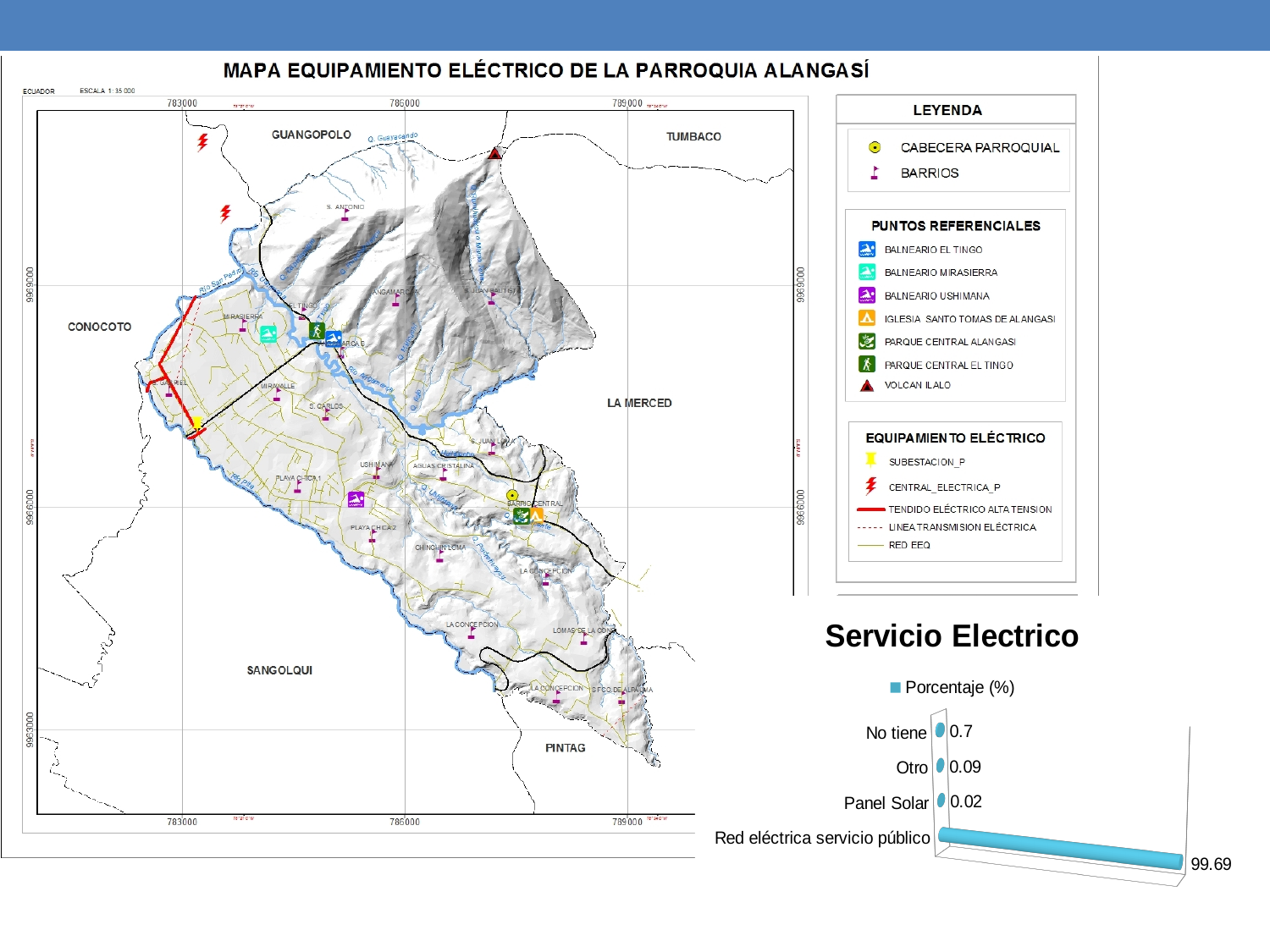
How many categories are shown in the 'Servicio Electrico' chart? 4 In the 'Servicio Electrico' chart, what is the value for 'Red eléctrica servicio público'? 99.69 In the 'Servicio Electrico' chart, which is larger: the value for 'Otro' or the value for 'Panel Solar'? Otro How many series does the legend of the 'Servicio Electrico' chart list? 1 In the 'Servicio Electrico' chart, what is the value for 'Otro'? 0.09 In the 'Servicio Electrico' chart, what is the value for 'Panel Solar'? 0.02 In the 'Servicio Electrico' chart, what is the value for 'No tiene'? 0.7 In the 'Servicio Electrico' chart, what is the difference between the values for 'No tiene' and 'Otro'? 0.61 In the 'Servicio Electrico' chart, which category has the highest value? Red eléctrica servicio público What kind of chart is the 'Servicio Electrico' chart? Bar chart What is the legend entry of the 'Servicio Electrico' chart? Porcentaje (%) In the 'Servicio Electrico' chart, which category has the lowest value? Panel Solar